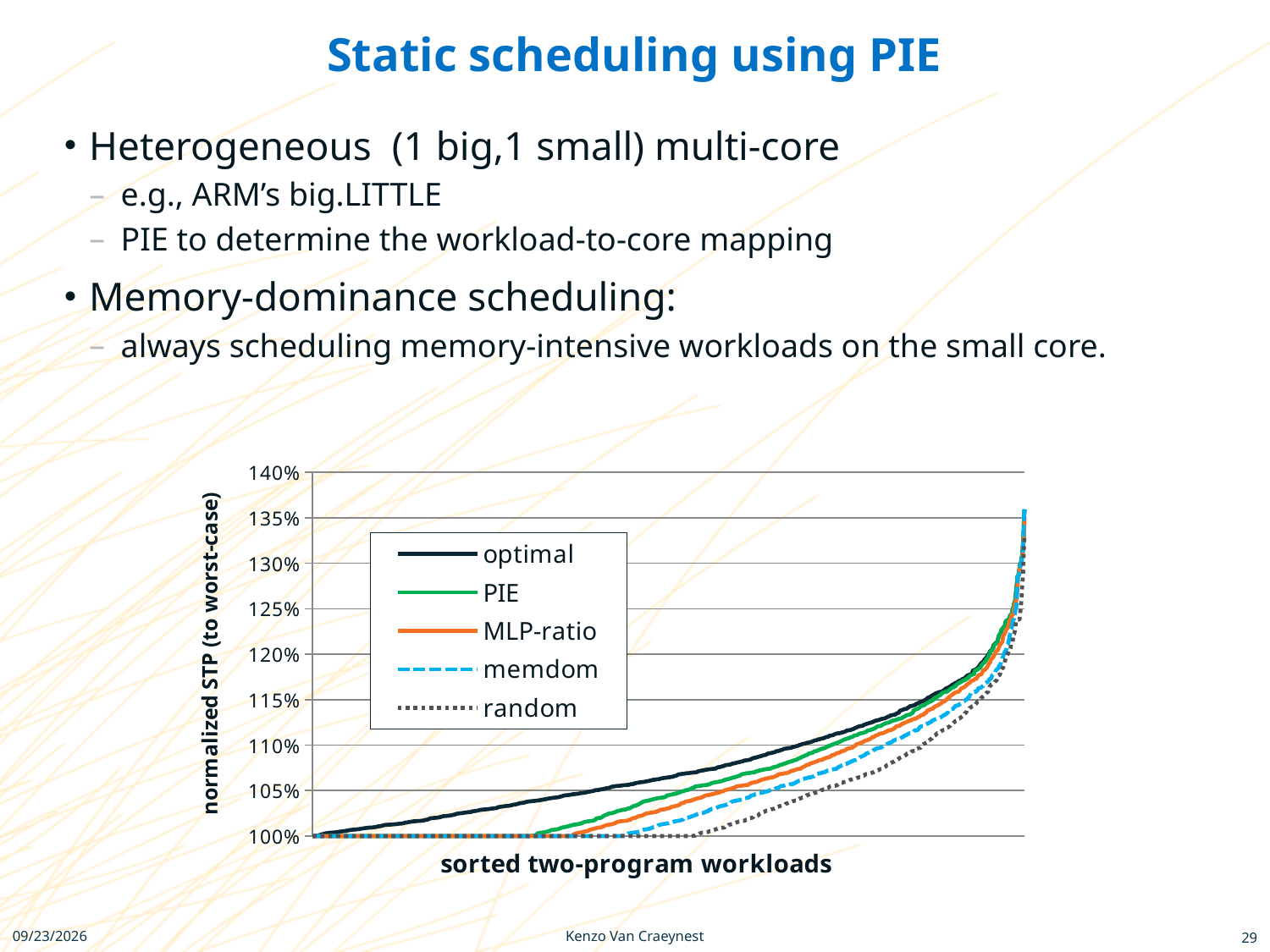
At the midpoint of the x axis, which series has the larger value, optimal or random? optimal Which series is plotted highest across most of the x axis? optimal Do the values of the optimal series rise or fall along the x axis? rise How many series does the chart's legend list? 5 What is the value of the random series at the left end of the x axis? 100% At the midpoint of the x axis, which series has the larger value, PIE or memdom? PIE What is the label of the chart's x axis? sorted two-program workloads Is the value of the optimal series at the midpoint of the x axis greater or less than 110%? less What is the label of the chart's y axis? normalized STP (to worst-case) Is the highest value reached by the optimal series greater or less than 130%? greater Which series is plotted lowest across most of the x axis? random What kind of chart is shown on the slide? line chart